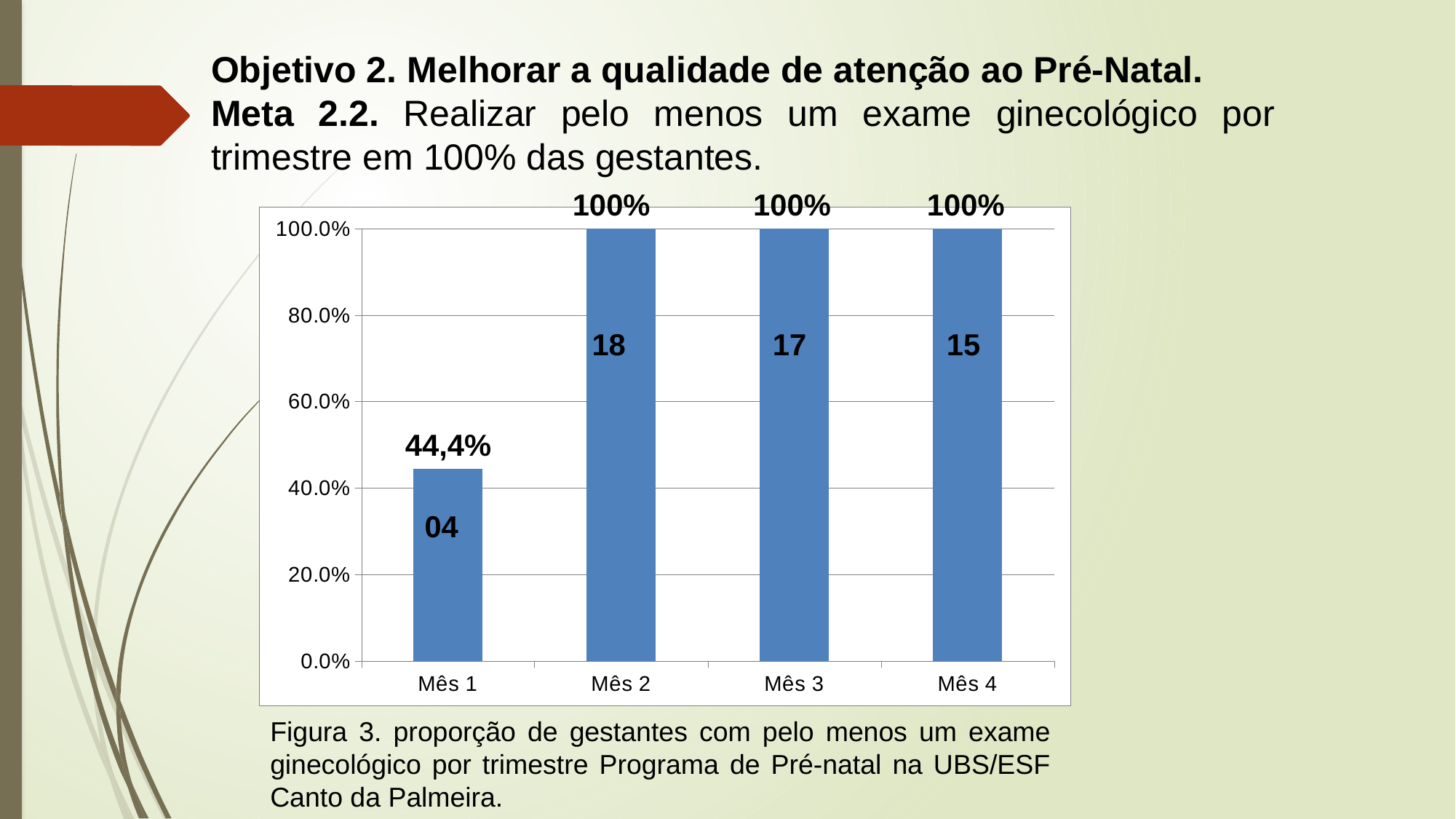
What count is printed inside the bar for Mês 4? 15 What count is printed inside the bar for Mês 2? 18 Which month has the lowest percentage? Mês 1 What is the difference between the counts printed for Mês 2 and Mês 3? 1 What is the percentage value shown for Mês 3? 100% How many months (categories) are shown on the x axis? 4 What is the percentage value shown for Mês 1? 44,4% Is the percentage for Mês 1 greater or less than 40.0%? greater What kind of chart is shown on the slide? Bar chart Which is larger, the percentage for Mês 1 or for Mês 2? Mês 2 What is the figure number given in the caption below the chart? Figura 3 What count is printed inside the bar for Mês 1? 04